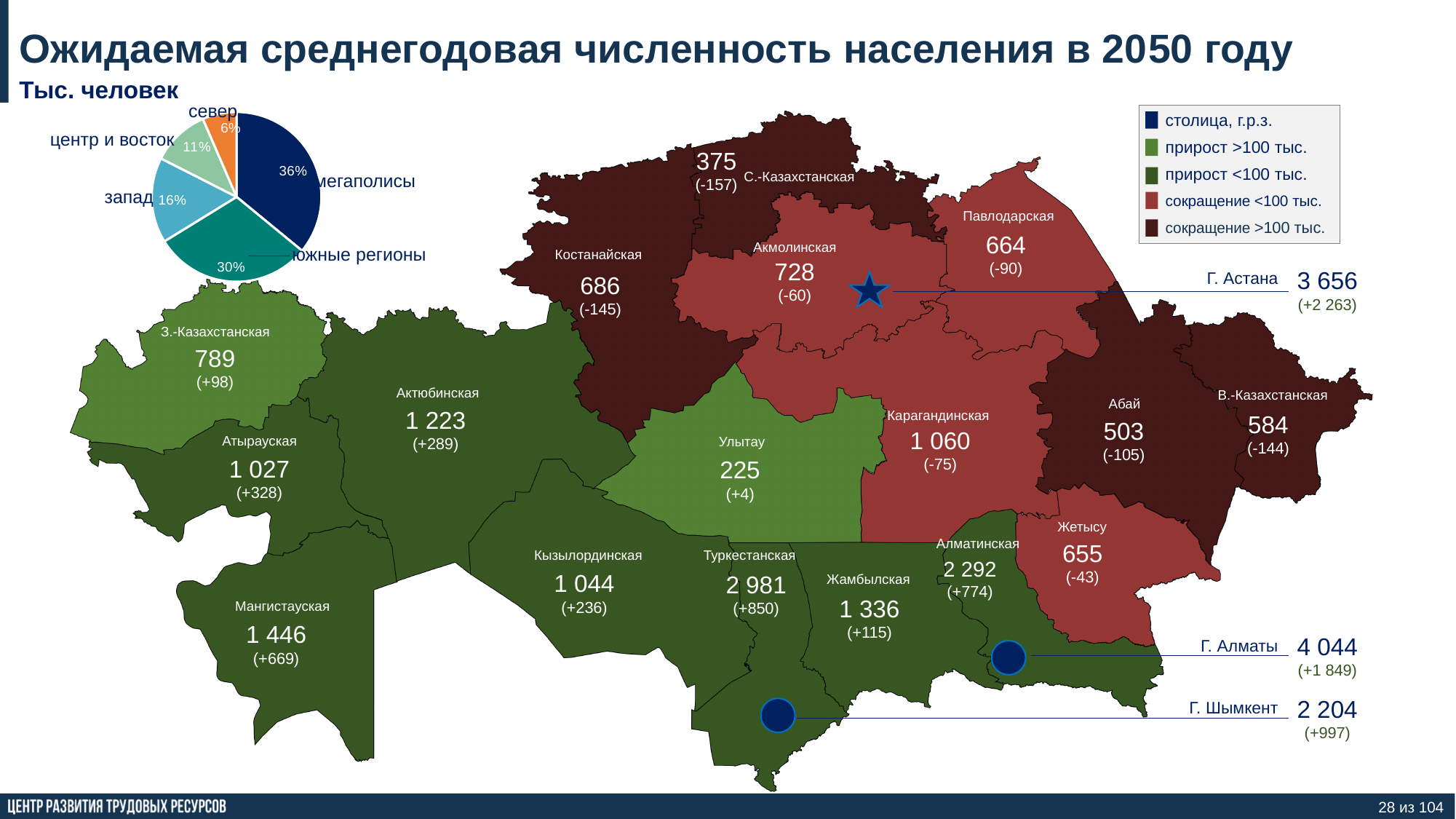
In the pie chart, what share does the slice 'мегаполисы' have? 36% In the pie chart, what is the difference in percentage points between 'мегаполисы' and 'южные регионы'? 6 In the pie chart, what share does the slice 'южные регионы' have? 30% In the pie chart, which slice is larger: 'запад' or 'центр и восток'? запад In the pie chart, which slice is the smallest? север What kind of chart is shown in the top-left corner of the slide? pie chart On the map, which region has the lowest expected population value? Улытау In the pie chart, how many slices are there? 5 On the map, what is the expected population value shown for Г. Алматы? 4 044 In the pie chart, which slice is the largest? мегаполисы On the map, what is the expected population value shown for Туркестанская? 2 981 How many entries does the map legend list? 5